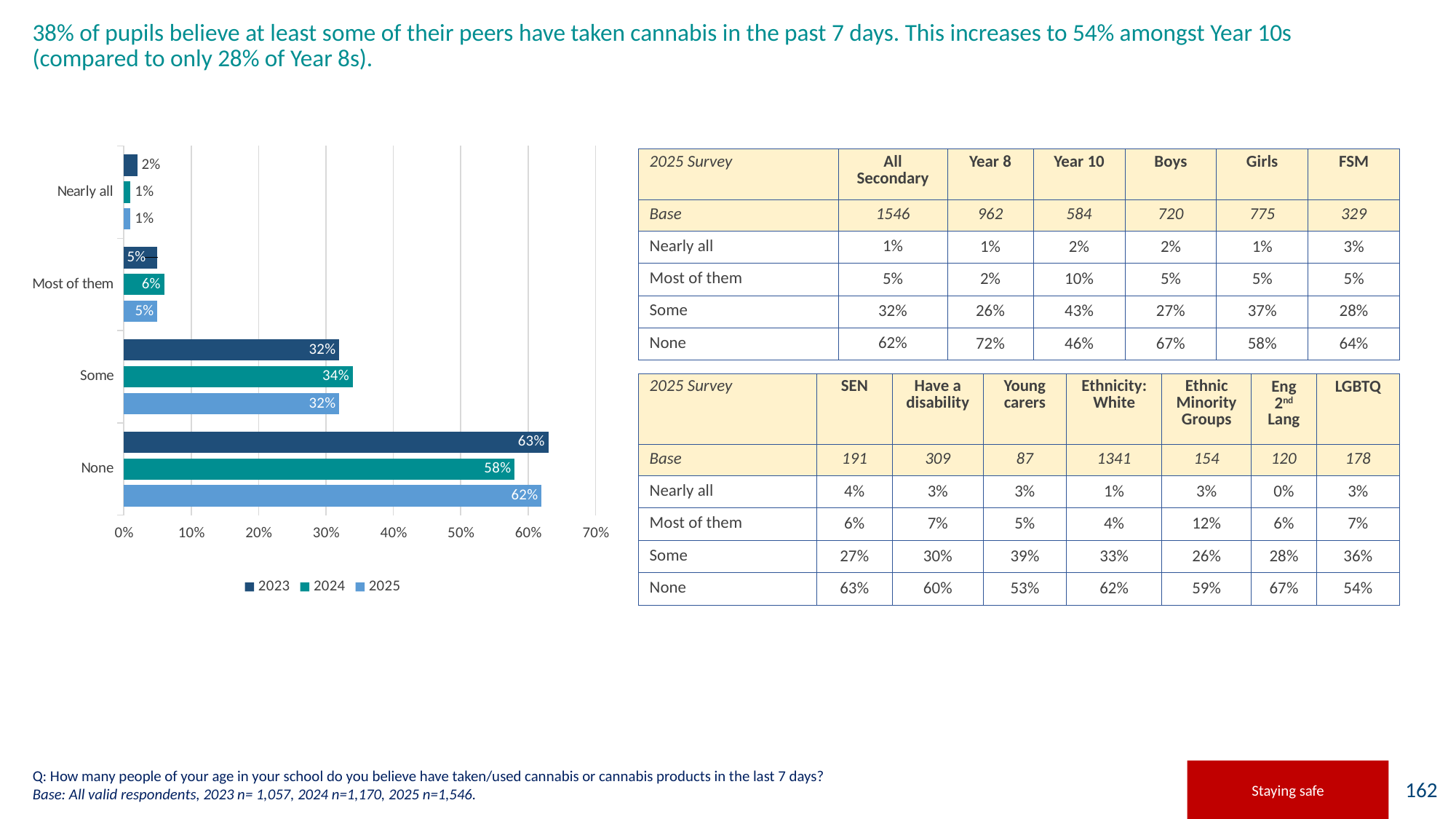
What is the difference between the 2023 and 2024 values for None? 5% What is the 2023 value for Some? 32% What is the 2024 value for Most of them? 6% How many categories are shown on the chart? 4 Which category has the lowest value in the 2023 series? Nearly all What is the 2025 value for None? 62% Which is larger for Some: the 2024 value or the 2025 value? 2024 What is the 2023 value for Nearly all? 2% What kind of chart is shown on the slide? bar chart How many series does the legend list? 3 Is the 2025 value for None greater or less than 50%? greater Which category has the highest value in the 2024 series? None